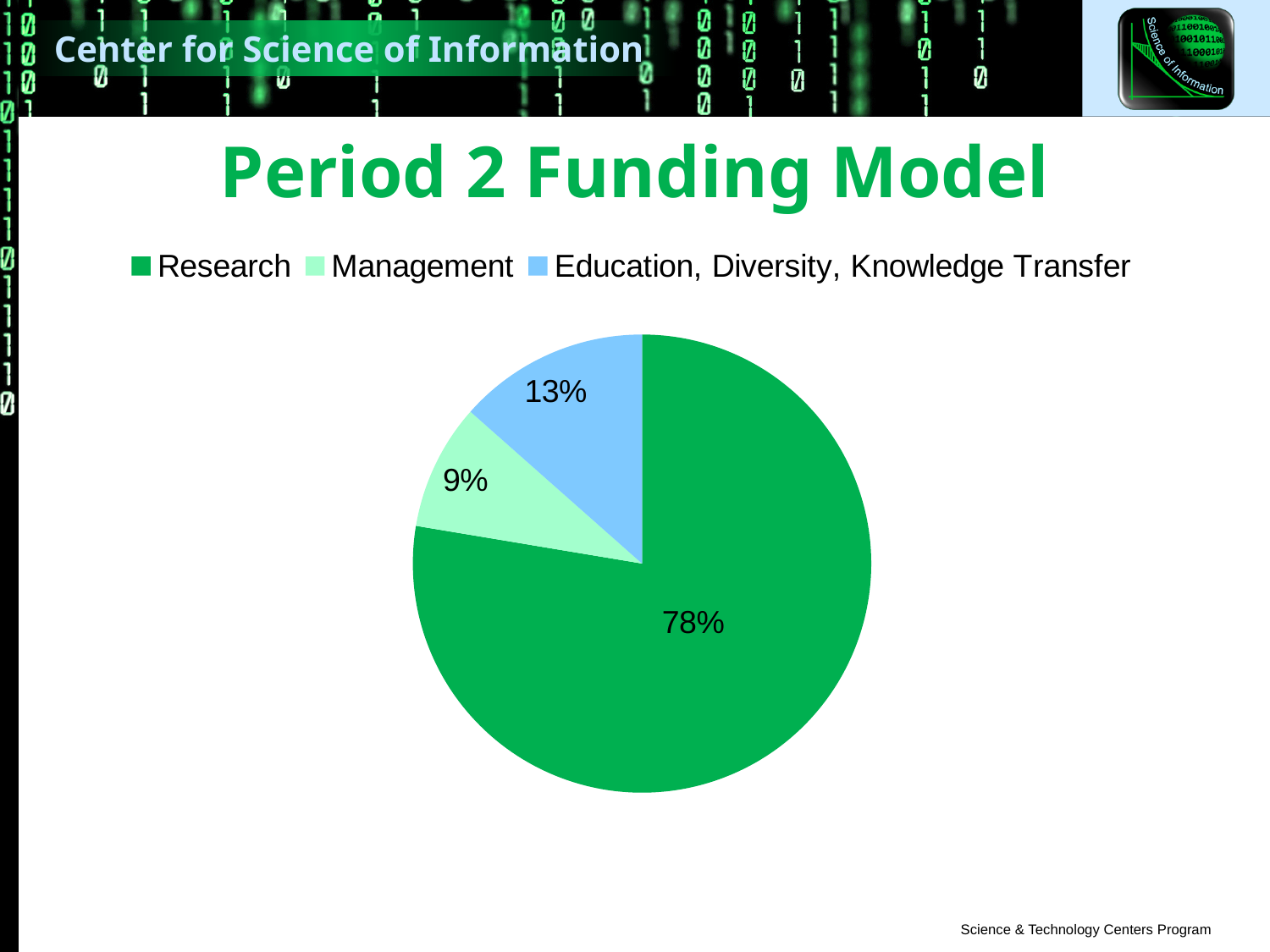
How many entries does the legend list? 3 What share of the pie does Management account for? 9% What colour is the Education, Diversity, Knowledge Transfer slice? light blue What type of chart is shown on the slide? pie chart What share of the pie does Research account for? 78% Which category has the largest slice of the pie? Research Which is larger, the Management slice or the Education, Diversity, Knowledge Transfer slice? Education, Diversity, Knowledge Transfer What is the difference in percentage points between the Research slice and the Education, Diversity, Knowledge Transfer slice? 65 How many slices does the pie chart have? 3 Which category has the smallest slice of the pie? Management What is the title of the chart on the slide? Period 2 Funding Model What share of the pie does Education, Diversity, Knowledge Transfer account for? 13%